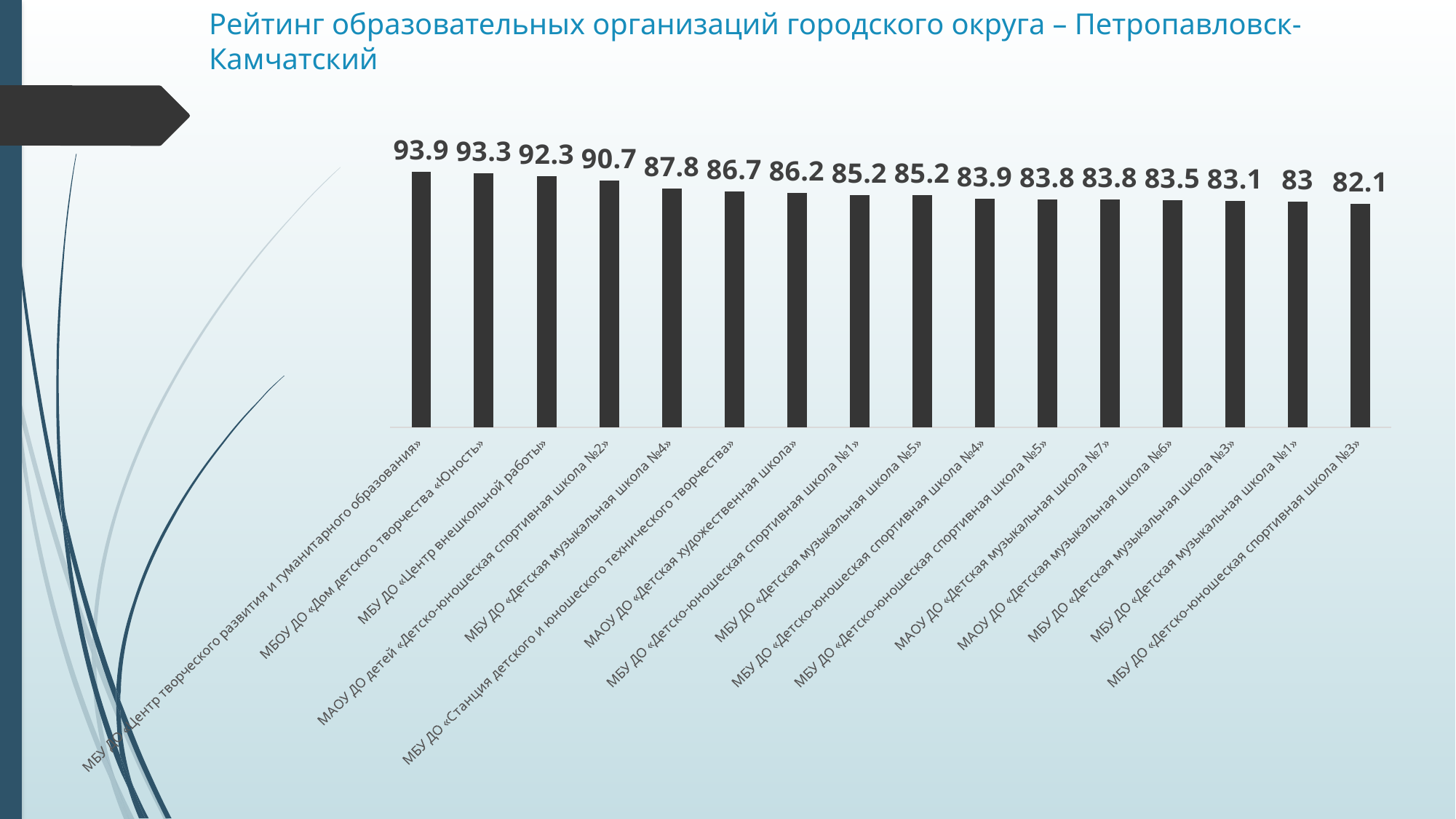
Which organisation has the lowest value in the chart? МБУ ДО «Детско-юношеская спортивная школа №3» How many bars (organisations) are plotted in the chart? 16 What is the value for МАОУ ДО «Детская художественная школа»? 86.2 Which has the larger value: МАОУ ДО детей «Детско-юношеская спортивная школа №2» or МБУ ДО «Станция детского и юношеского технического творчества»? МАОУ ДО детей «Детско-юношеская спортивная школа №2» What is the value for МБУ ДО «Детская музыкальная школа №1»? 83 What is the value for МБУ ДО «Центр внешкольной работы»? 92.3 What is the value for МБУ ДО «Детская музыкальная школа №4»? 87.8 Which organisation has the highest value in the chart? МБУ ДО «Центр творческого развития и гуманитарного образования» What type of chart is shown on the slide? bar chart What is the difference between the values for МБОУ ДО «Дом детского творчества «Юность» and МБУ ДО «Детско-юношеская спортивная школа №3»? 11.2 Do the values rise or fall from left to right along the x axis? fall What is the title of the slide containing the chart? Рейтинг образовательных организаций городского округа – Петропавловск-Камчатский